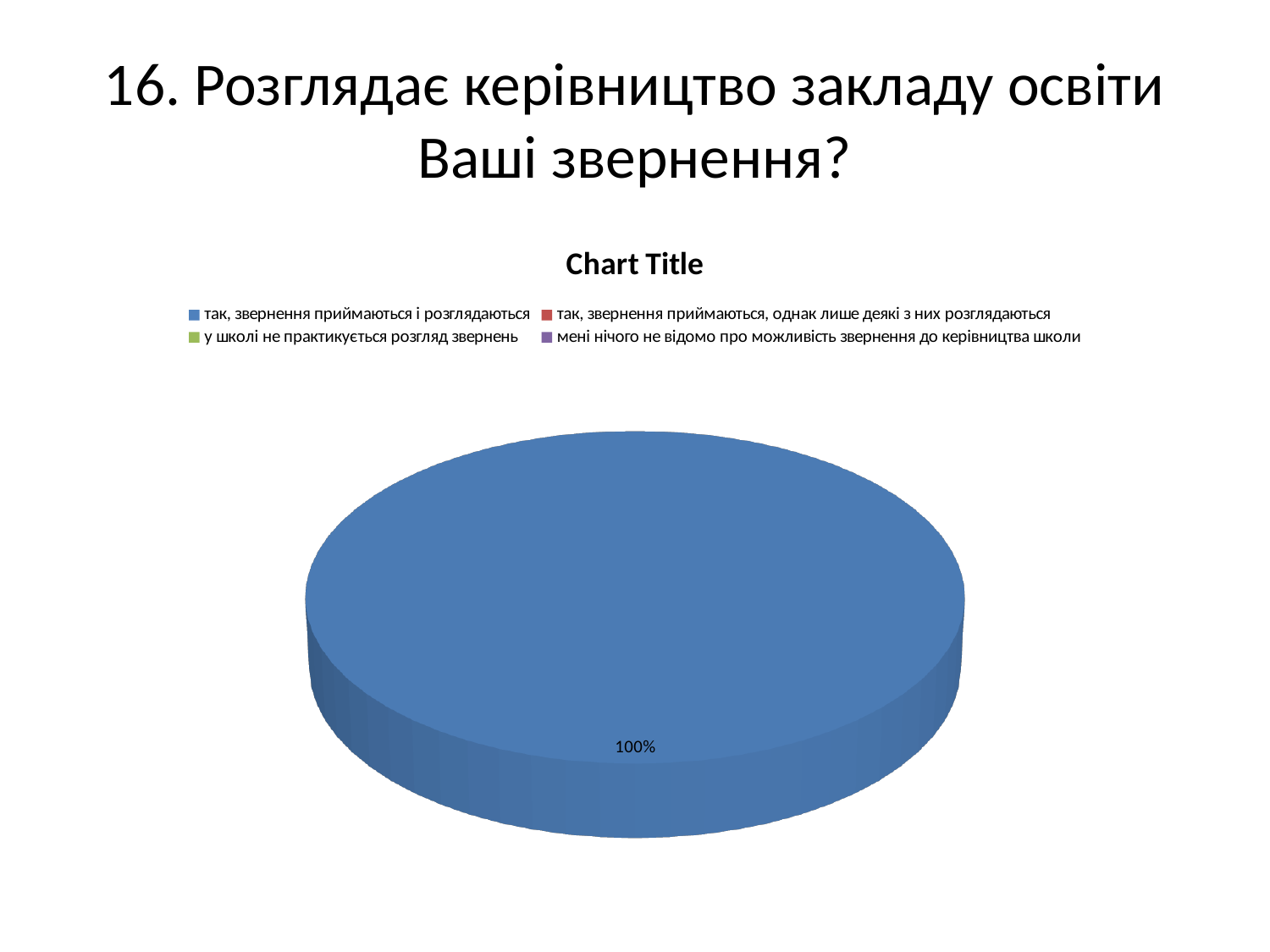
How many slices are visible in the pie? 1 What kind of chart is shown on the slide? pie chart Which is larger: the share for "так, звернення приймаються і розглядаються" or the share for "у школі не практикується розгляд звернень"? так, звернення приймаються і розглядаються What share of the pie does the slice for "так, звернення приймаються і розглядаються" represent? 100% How many entries does the chart legend list? 4 What is the title printed above the chart? Chart Title What colour is the slice that makes up the whole pie? blue What percentage value is printed as a data label on the pie? 100% Is the share for "так, звернення приймаються і розглядаються" greater or less than 50%? greater Which category accounts for the largest share of the pie? так, звернення приймаються і розглядаються